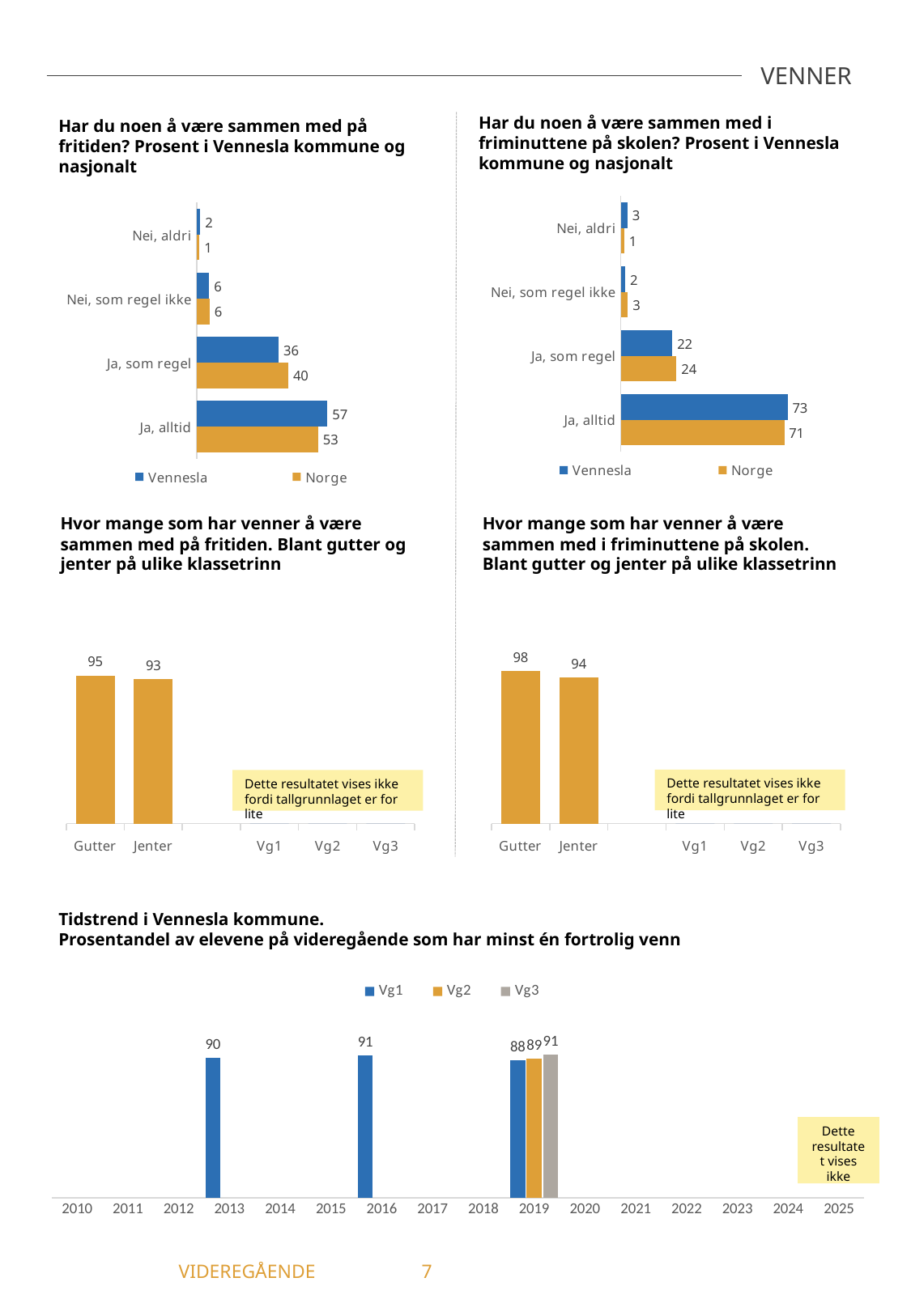
In the middle-right chart 'Hvor mange som har venner å være sammen med i friminuttene på skolen', what is the difference between Gutter and Jenter? 4 In the middle-left chart 'Hvor mange som har venner å være sammen med på fritiden', what is the value for Gutter? 95 In the bottom chart 'Tidstrend i Vennesla kommune', what is the value for Vg3 in 2019? 91 In the top-right chart 'Har du noen å være sammen med i friminuttene på skolen?', which is larger for 'Ja, som regel': Vennesla or Norge? Norge In the bottom chart 'Tidstrend i Vennesla kommune', what is the value for Vg1 in 2013? 90 In the top-left chart 'Har du noen å være sammen med på fritiden?', what is the difference between Vennesla and Norge for 'Ja, alltid'? 4 What kind of chart is the bottom chart 'Tidstrend i Vennesla kommune'? Bar chart In the top-right chart 'Har du noen å være sammen med i friminuttene på skolen?', what is the value for Vennesla in the 'Ja, alltid' category? 73 How many series does the legend list in the top-left chart 'Har du noen å være sammen med på fritiden?'? 2 In the top-left chart 'Har du noen å være sammen med på fritiden?', what is the value for Norge in the 'Ja, som regel' category? 40 In the top-right chart 'Har du noen å være sammen med i friminuttene på skolen?', which category has the lowest value for Norge? Nei, aldri In the top-left chart 'Har du noen å være sammen med på fritiden?', what is the value for Vennesla in the 'Ja, alltid' category? 57